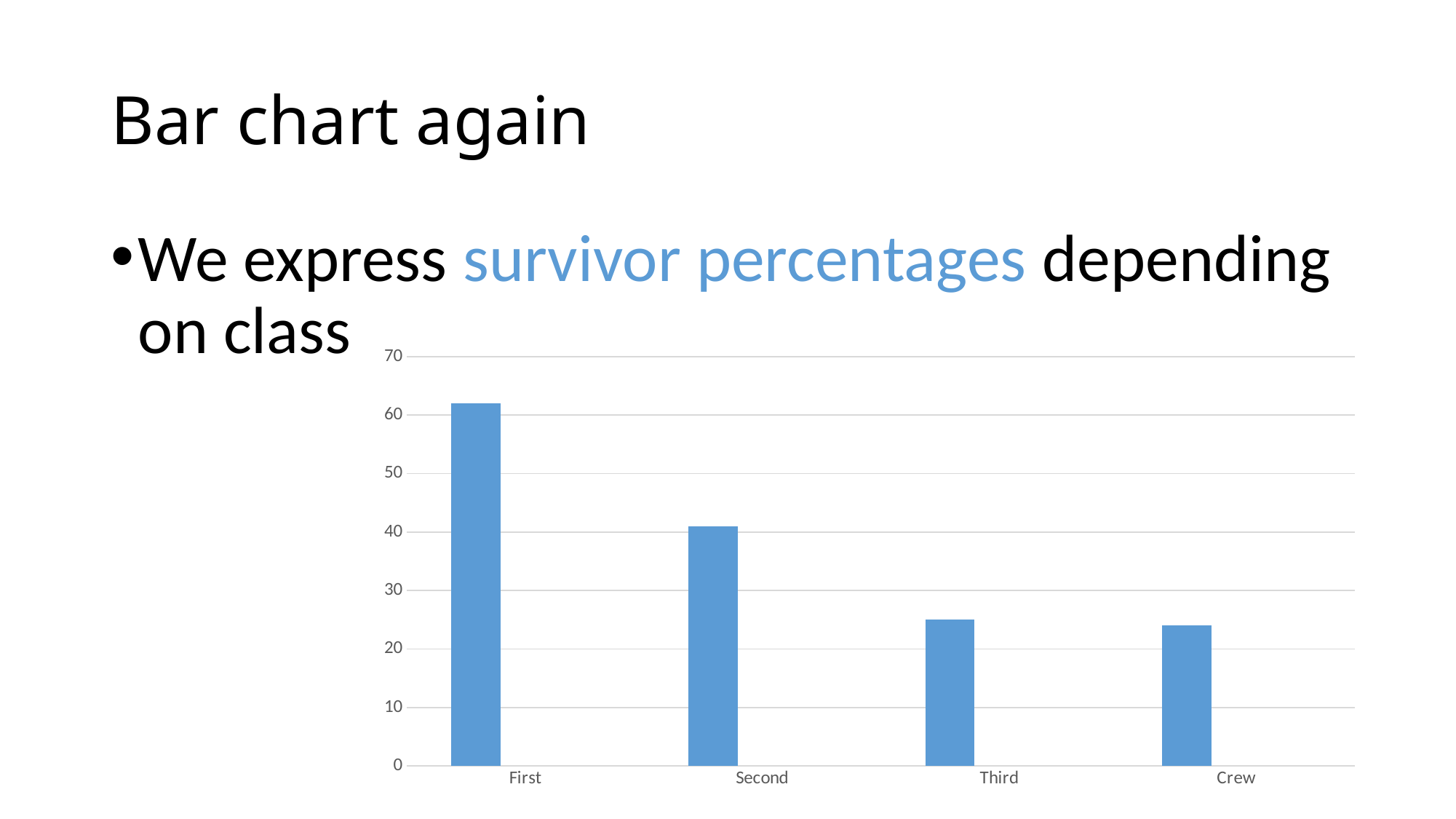
Is the value for Crew greater or less than 20? greater Is the value for First greater or less than 50? greater Which category has the highest bar in the chart? First Which is larger, the value for First or the value for Second? First Is the value for Second greater or less than 50? less What is the highest value shown on the vertical axis of the chart? 70 How many categories are shown on the x axis of the chart? 4 Do the bar values generally rise or fall from First to Crew along the x axis? fall Which is larger, the value for Second or the value for Crew? Second What kind of chart is shown on the slide? bar chart